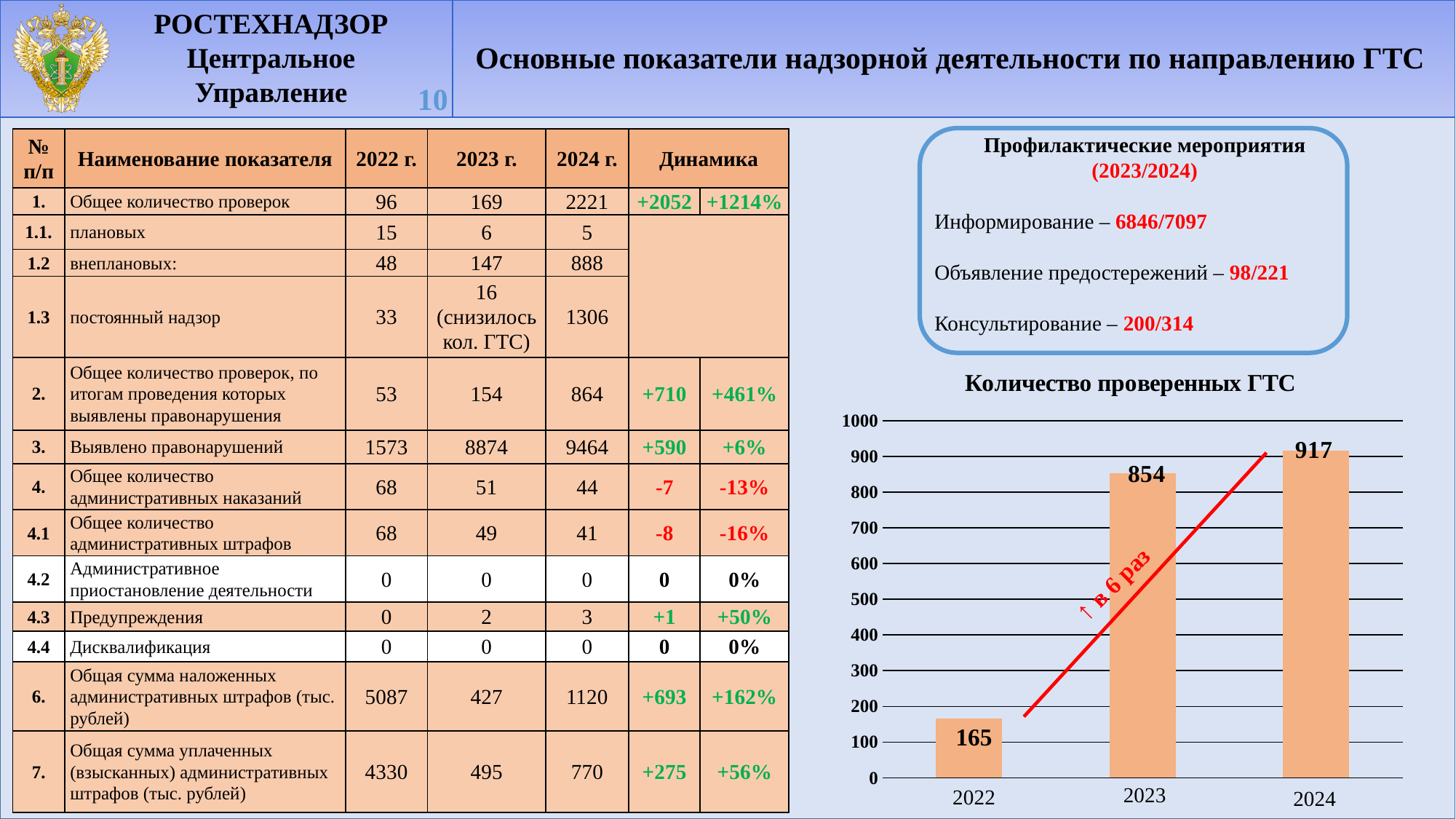
Is the value for 2022 in the chart "Количество проверенных ГТС" greater or less than 200? less What is the difference between the 2023 and 2022 values in the chart "Количество проверенных ГТС"? 689 What is the value for 2022 in the chart "Количество проверенных ГТС"? 165 Which year has the highest value in the chart "Количество проверенных ГТС"? 2024 Do the values in the chart "Количество проверенных ГТС" rise or fall from 2022 to 2024? rise In the chart "Количество проверенных ГТС", which is larger: the value for 2022 or the value for 2023? 2023 What kind of chart is "Количество проверенных ГТС"? bar chart What is the value for 2023 in the chart "Количество проверенных ГТС"? 854 Which year has the lowest value in the chart "Количество проверенных ГТС"? 2022 What is the value for 2024 in the chart "Количество проверенных ГТС"? 917 What is the difference between the 2024 and 2023 values in the chart "Количество проверенных ГТС"? 63 How many years (bars) are shown in the chart "Количество проверенных ГТС"? 3